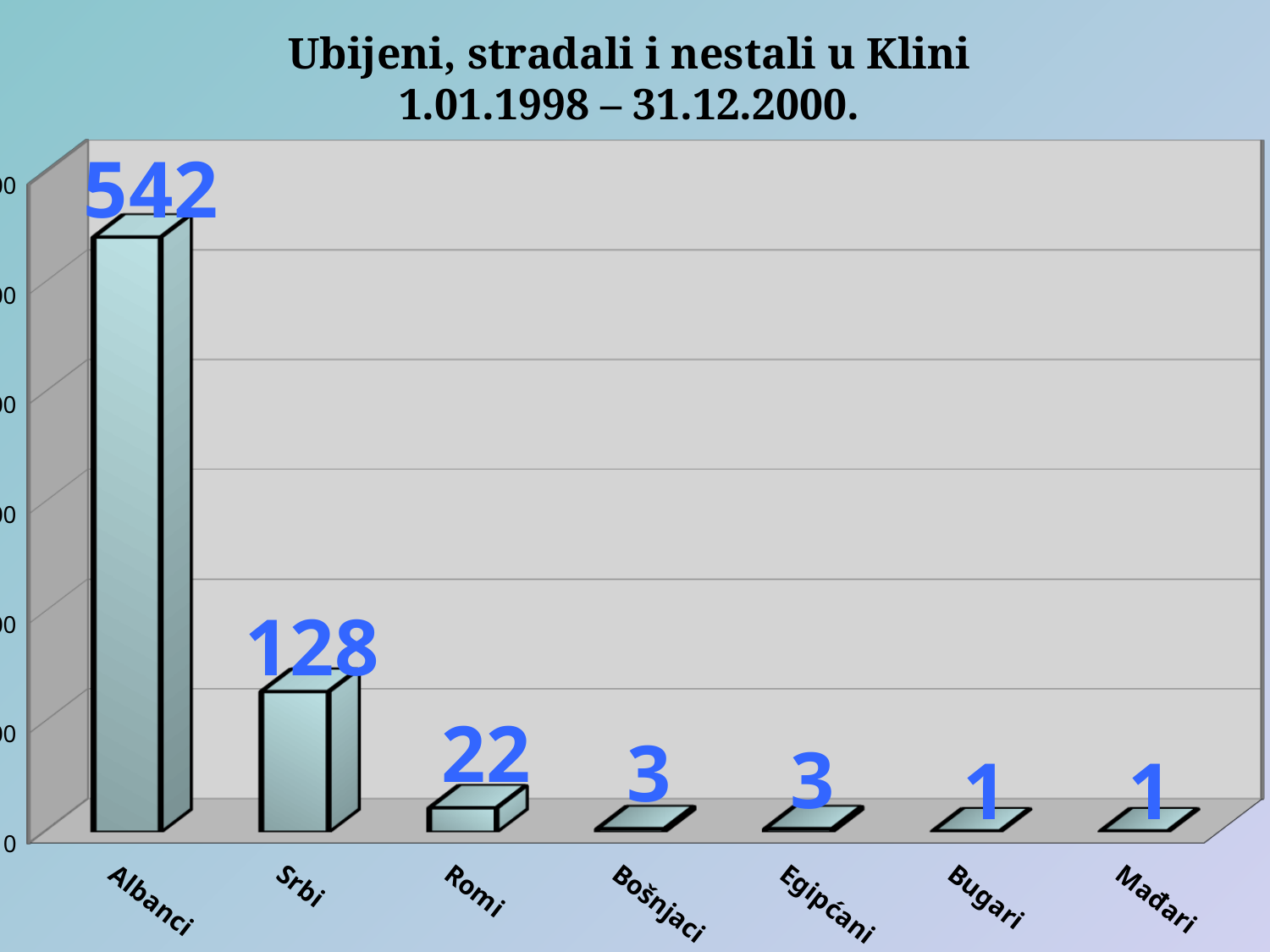
Which is larger, the value for Romi or the value for Egipćani? Romi What is the value for Bošnjaci? 3 What is the value for Albanci? 542 What kind of chart is shown on the slide? Bar chart How many categories are shown on the x axis? 7 What is the difference between the values for Srbi and Romi? 106 Which category has the highest value? Albanci What is the title of the chart? Ubijeni, stradali i nestali u Klini 1.01.1998 – 31.12.2000. What is the value for Mađari? 1 What is the difference between the values for Albanci and Srbi? 414 What is the value for Romi? 22 What is the value for Srbi? 128